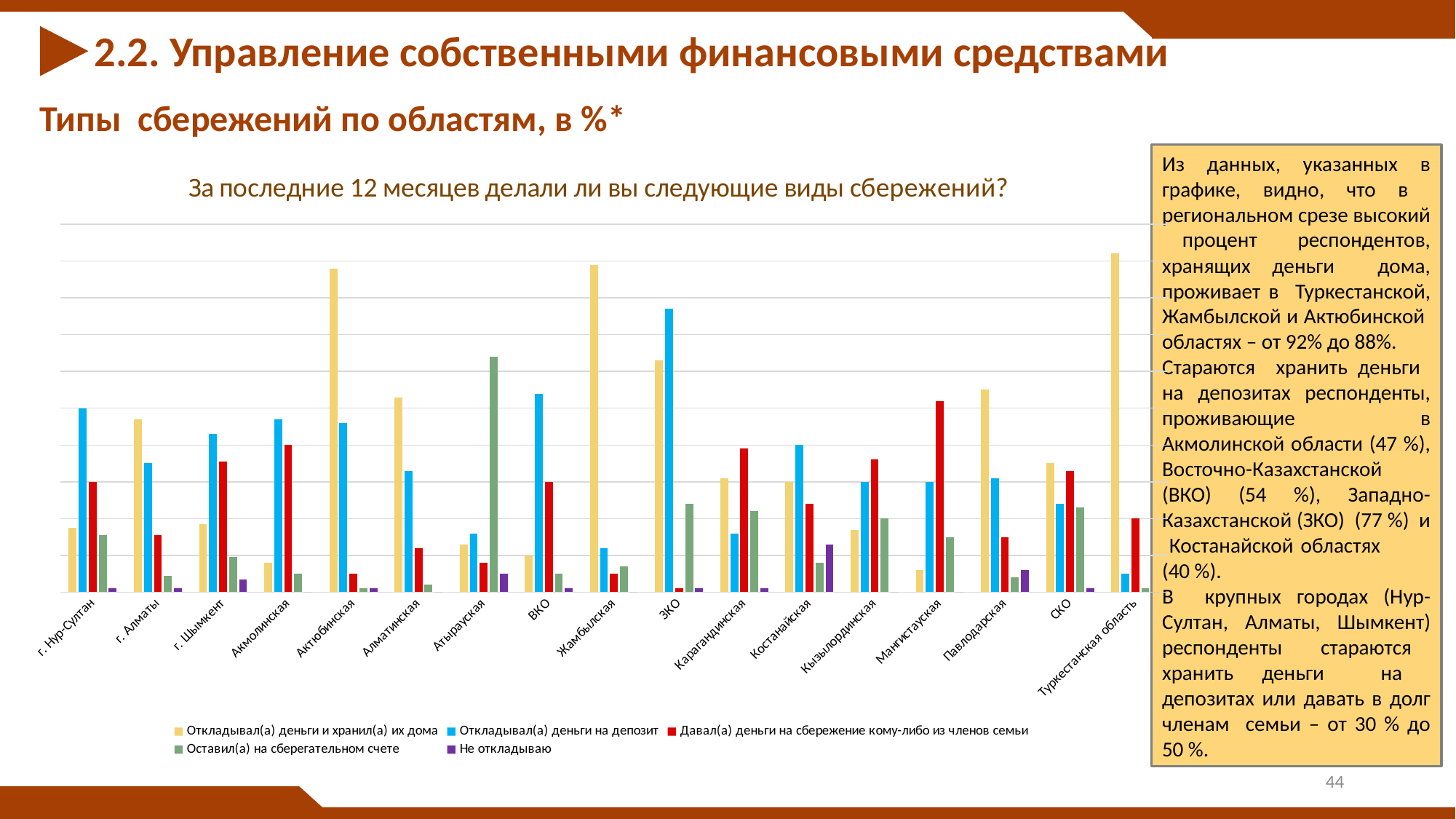
Which colour represents the series 'Не откладываю' in the chart? purple Which region has the highest value for the series 'Оставил(а) на сберегательном счете'? Атырауская What is the title of the chart? За последние 12 месяцев делали ли вы следующие виды сбережений? For Атырауская, which is larger: 'Оставил(а) на сберегательном счете' or 'Откладывал(а) деньги на депозит'? Оставил(а) на сберегательном счете What kind of chart is shown on the slide? bar chart How many regions (categories) are shown on the x axis of the chart? 17 Which region has the highest value for the series 'Давал(а) деньги на сбережение кому-либо из членов семьи'? Мангистауская How many series does the chart legend list? 5 Which region has the highest value for the series 'Откладывал(а) деньги на депозит'? ЗКО For Мангистауская, which is larger: 'Давал(а) деньги на сбережение кому-либо из членов семьи' or 'Откладывал(а) деньги на депозит'? Давал(а) деньги на сбережение кому-либо из членов семьи For г. Нур-Султан, which is larger: 'Откладывал(а) деньги на депозит' or 'Откладывал(а) деньги и хранил(а) их дома'? Откладывал(а) деньги на депозит